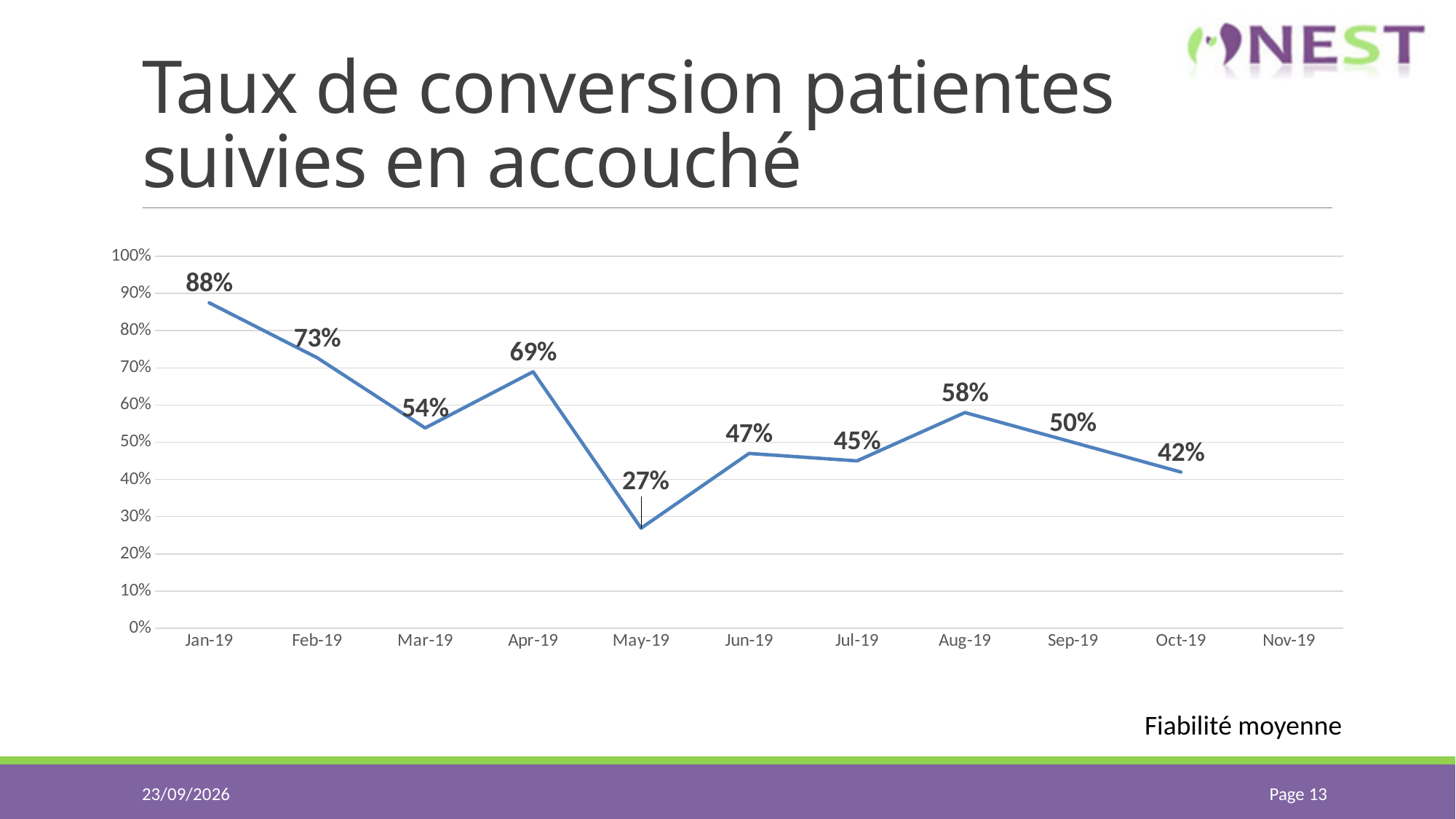
What is the difference between the values for Apr-19 and May-19? 42% What is the difference between the values for Jan-19 and Feb-19? 15% Is the value for Oct-19 greater or less than 50%? less Which month has the highest conversion rate? Jan-19 What is the value shown for Aug-19? 58% What kind of chart is shown on the slide? line chart What is the value shown for May-19? 27% Which month has the lowest conversion rate? May-19 Which is larger, the value for Jun-19 or the value for Jul-19? Jun-19 How many months have a plotted data point with a value label? 10 Do the values generally rise or fall from Jan-19 to Mar-19? fall What is the conversion rate for Jan-19? 88%